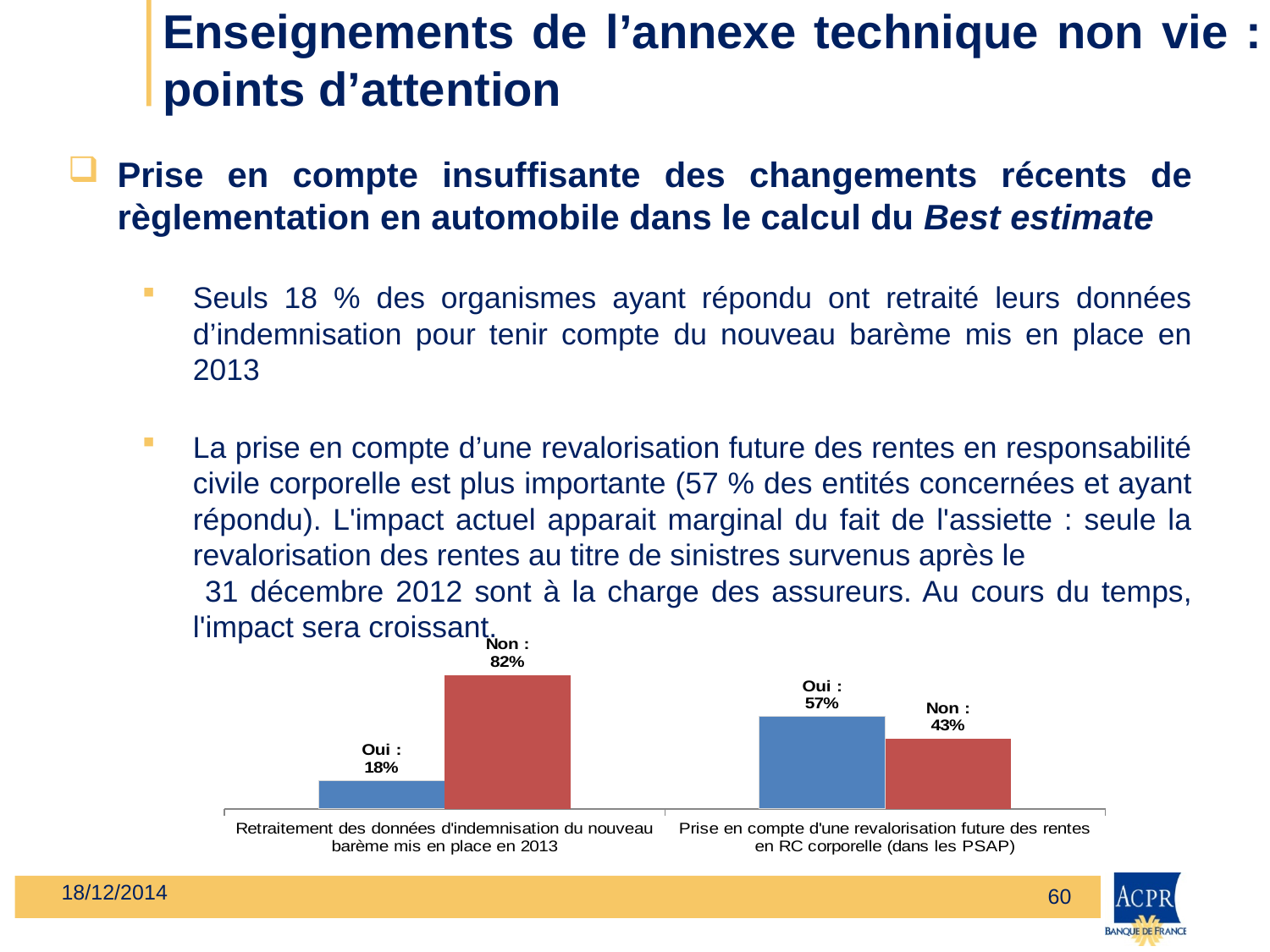
What type of chart is shown on the slide? bar chart Which bar on the chart has the lowest value? Oui : 18% Which bar on the chart has the highest value? Non : 82% What is the value of the "Non" bar for "Retraitement des données d'indemnisation du nouveau barème mis en place en 2013"? 82% What is the difference between the "Non" and "Oui" values for "Retraitement des données d'indemnisation du nouveau barème mis en place en 2013"? 64% How many categories are shown on the x axis of the chart? 2 For "Prise en compte d'une revalorisation future des rentes en RC corporelle (dans les PSAP)", which is larger, "Oui" or "Non"? Oui What is the difference between the "Oui" and "Non" values for "Prise en compte d'une revalorisation future des rentes en RC corporelle (dans les PSAP)"? 14% What is the value of the "Oui" bar for "Prise en compte d'une revalorisation future des rentes en RC corporelle (dans les PSAP)"? 57% Is the "Oui" value for "Retraitement des données d'indemnisation du nouveau barème mis en place en 2013" larger or smaller than the "Oui" value for "Prise en compte d'une revalorisation future des rentes en RC corporelle (dans les PSAP)"? smaller What is the value of the "Non" bar for "Prise en compte d'une revalorisation future des rentes en RC corporelle (dans les PSAP)"? 43% What is the value of the "Oui" bar for "Retraitement des données d'indemnisation du nouveau barème mis en place en 2013"? 18%